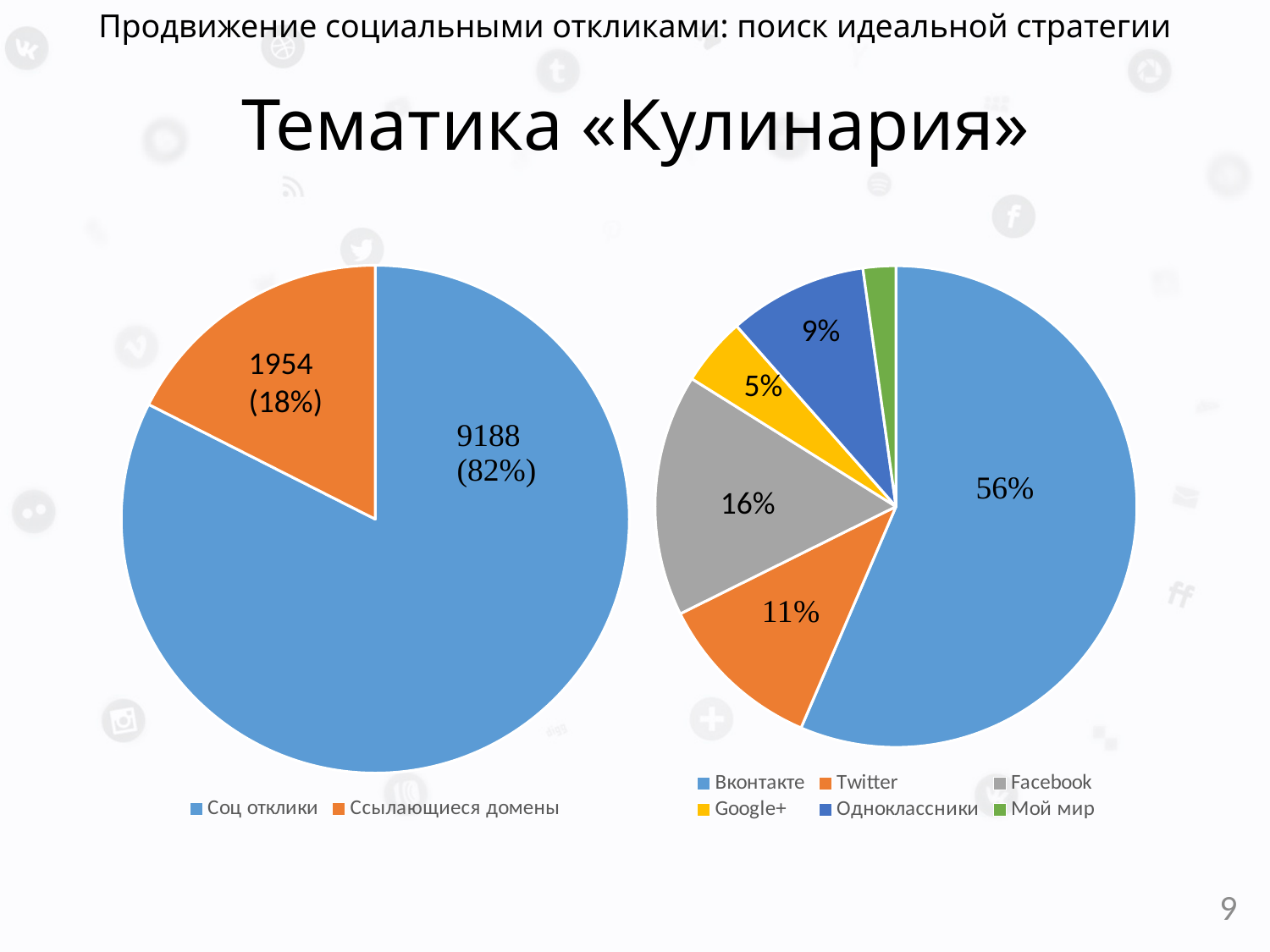
In the right pie chart, what percentage is shown for Вконтакте? 56% In the right pie chart, which category has the largest share? Вконтакте In the left pie chart, what is the difference between the values for Соц отклики and Ссылающиеся домены? 7234 In the right pie chart, what percentage is shown for Facebook? 16% In the left pie chart, what value is shown for Ссылающиеся домены? 1954 (18%) What type of chart is used on the right side of the slide? Pie chart In the left pie chart, what share of the pie does Ссылающиеся домены take? 18% In the left pie chart, how many categories does the legend list? 2 In the right pie chart, which is larger, Twitter or Одноклассники? Twitter In the right pie chart, how many categories does the legend list? 6 In the left pie chart, what value is shown for Соц отклики? 9188 (82%) In the right pie chart, what percentage is shown for Google+? 5%